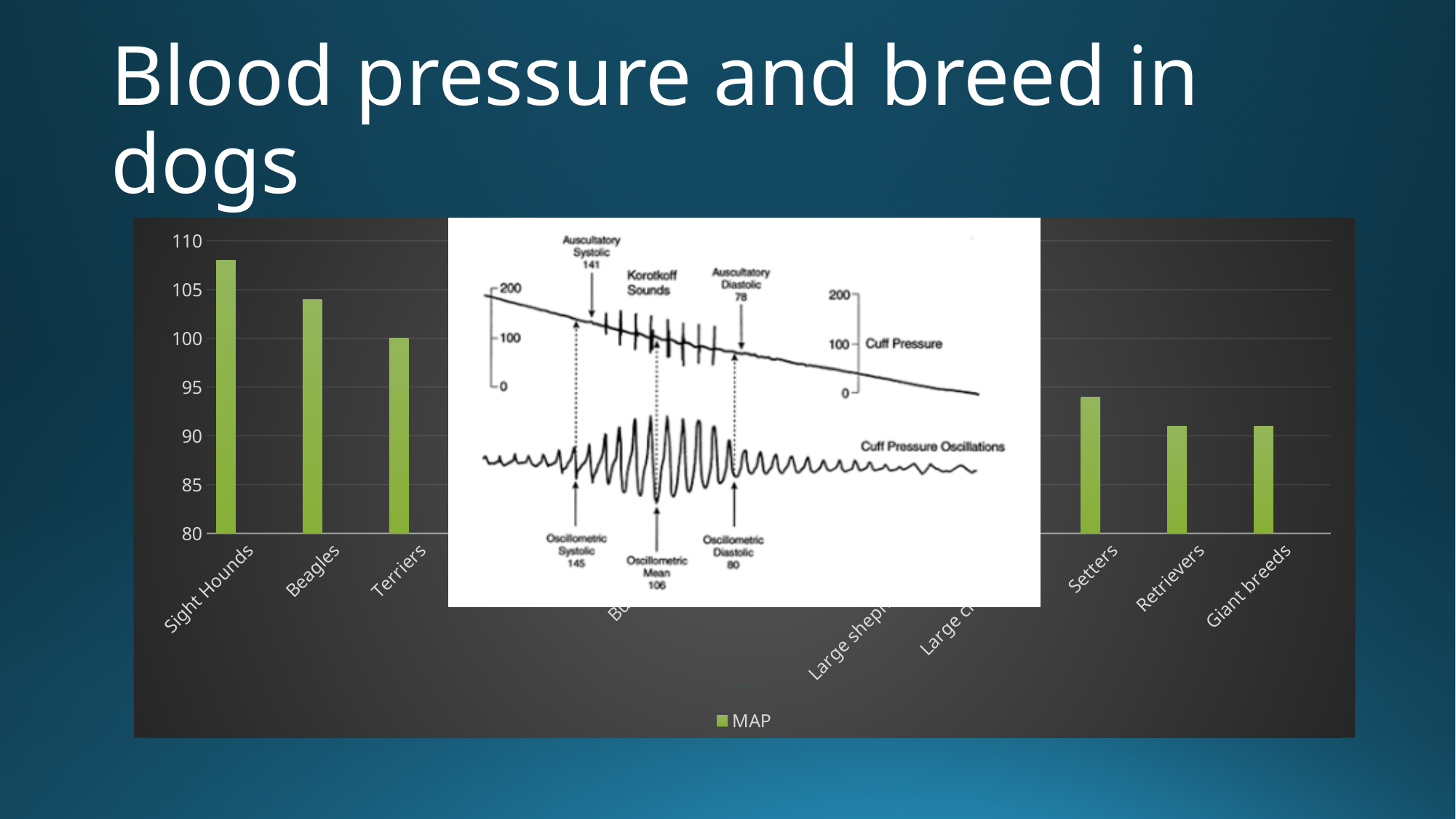
Is the value for Beagles greater or less than 100? greater Which has the higher MAP value, Setters or Retrievers? Setters Is the value for Giant breeds greater or less than 90? greater Is the value for Retrievers greater or less than 95? less Do the bars rise or fall going from Sight Hounds to Terriers? fall What is the name of the series shown in the chart legend? MAP What is the MAP value for Terriers? 100 Which has the higher MAP value, Sight Hounds or Beagles? Sight Hounds How many series does the chart legend list? 1 What kind of chart is shown on the slide? bar chart